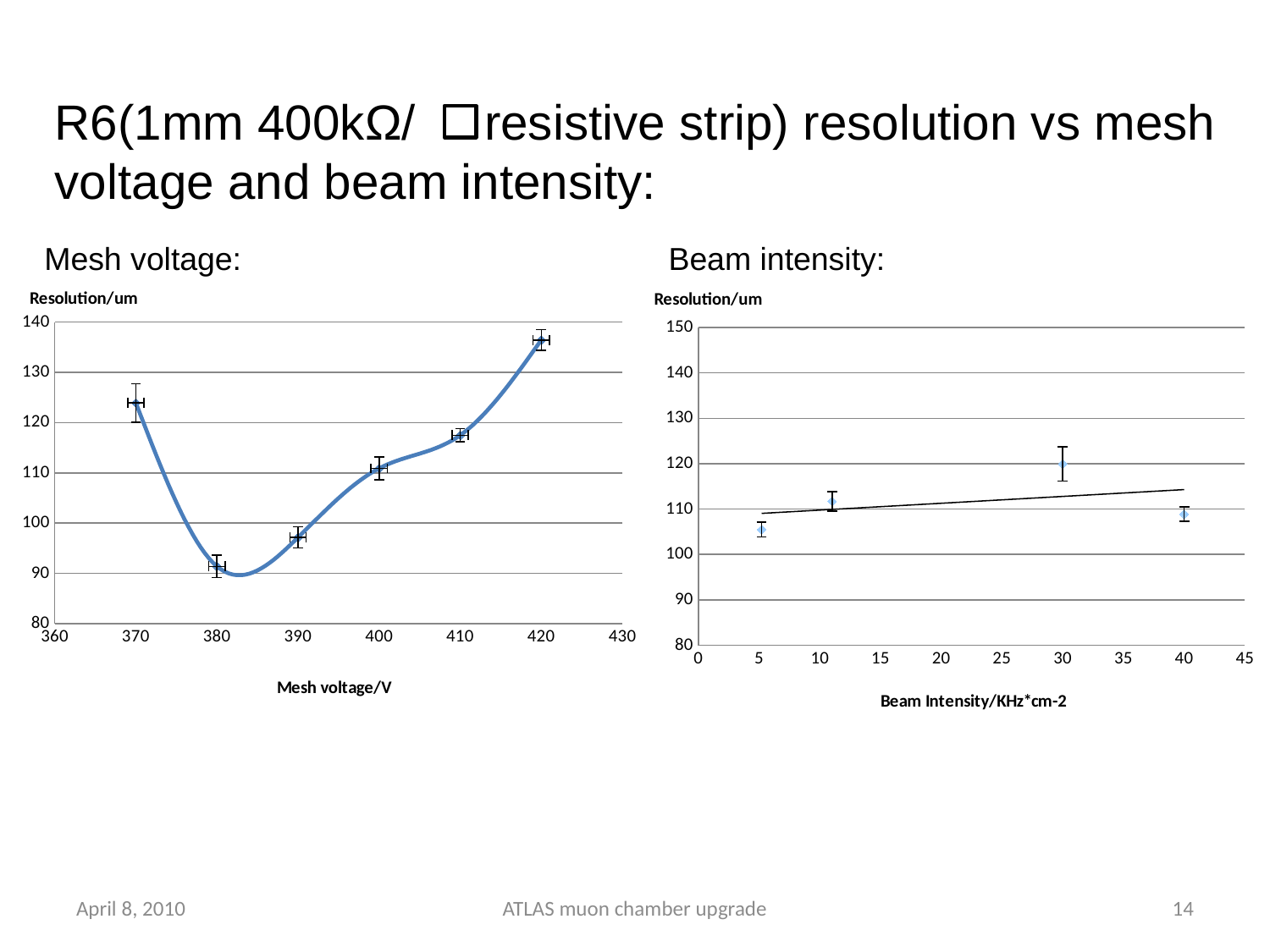
On the Mesh voltage chart (left), is the resolution at 370 V greater or less than 120? greater On the Beam intensity chart (right), at which beam intensity is the resolution highest? 30 On the Mesh voltage chart (left), how many data points are plotted? 6 On the Mesh voltage chart (left), which has the larger resolution: 390 V or 400 V? 400 V On the Mesh voltage chart (left), at which mesh voltage is the resolution lowest? 380 On the Beam intensity chart (right), what is the x-axis title? Beam Intensity/KHz*cm-2 On the Beam intensity chart (right), how many data points are plotted? 4 On the Mesh voltage chart (left), what is the x-axis title? Mesh voltage/V On the Beam intensity chart (right), is the resolution at beam intensity 30 greater or less than 110? greater On the Mesh voltage chart (left), at which mesh voltage is the resolution highest? 420 On the Mesh voltage chart (left), is the resolution at 380 V greater or less than 100? less